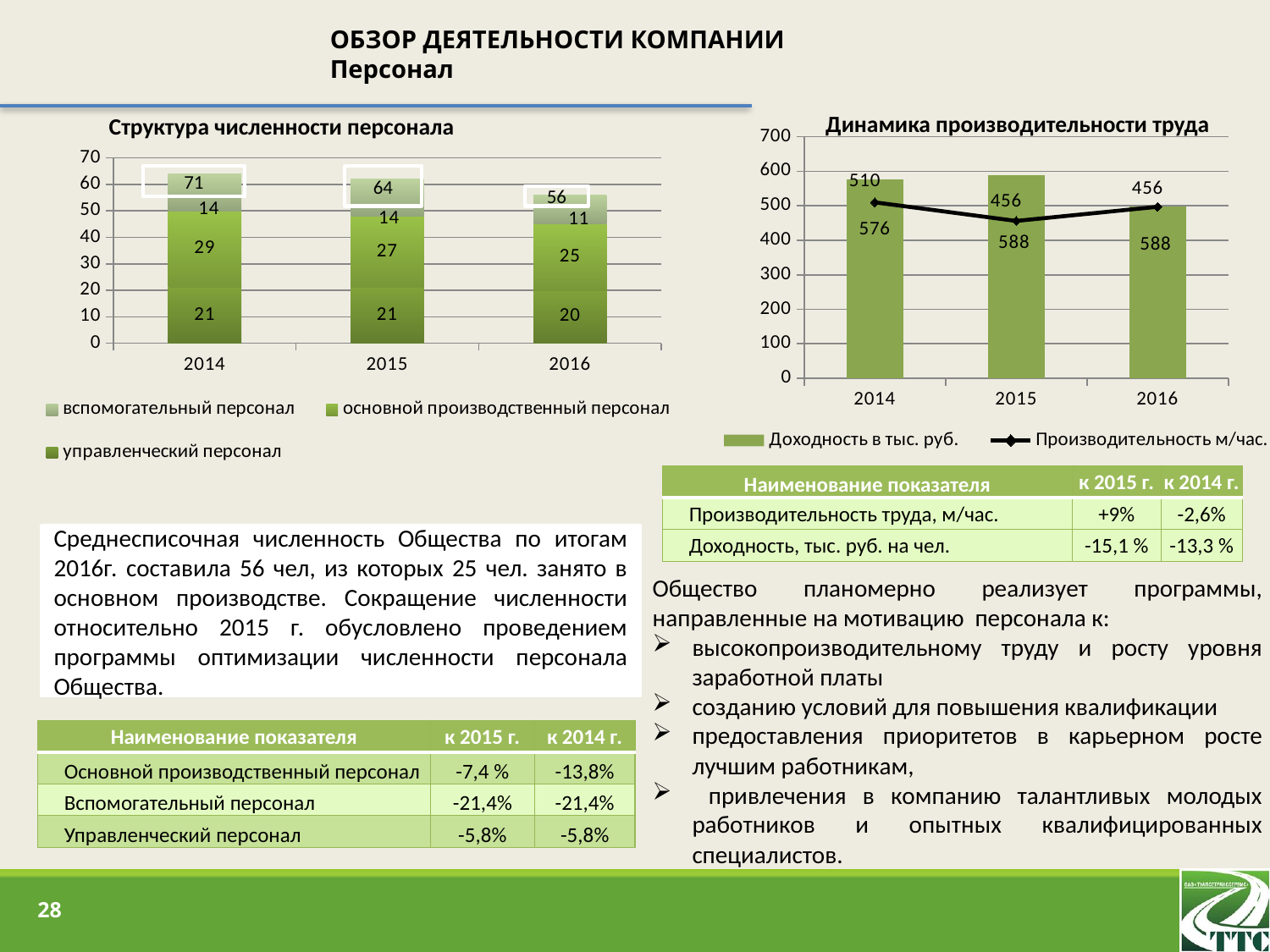
In the 'Динамика производительности труда' chart, what is the difference in Производительность м/час between 2014 and 2015? 54 In the 'Структура численности персонала' chart, which year has the larger value for вспомогательный персонал, 2015 or 2016? 2015 In the 'Структура численности персонала' chart, what is the value for вспомогательный персонал in 2016? 11 In the 'Структура численности персонала' chart, does основной производственный персонал rise or fall from 2014 to 2016? fall In the 'Структура численности персонала' chart, what is the value for управленческий персонал in 2014? 21 In the 'Структура численности персонала' chart, what is the value for основной производственный персонал in 2016? 25 In the 'Динамика производительности труда' chart, what is the value of Доходность в тыс. руб. for 2015? 588 How many series does the legend of the 'Структура численности персонала' chart list? 3 In the 'Динамика производительности труда' chart, what is the value of Производительность м/час for 2014? 510 In the 'Структура численности персонала' chart, by how much did основной производственный персонал decrease from 2014 to 2016? 4 How many years are shown on the x axis of the 'Структура численности персонала' chart? 3 What kind of chart is the 'Структура численности персонала' chart? stacked bar chart